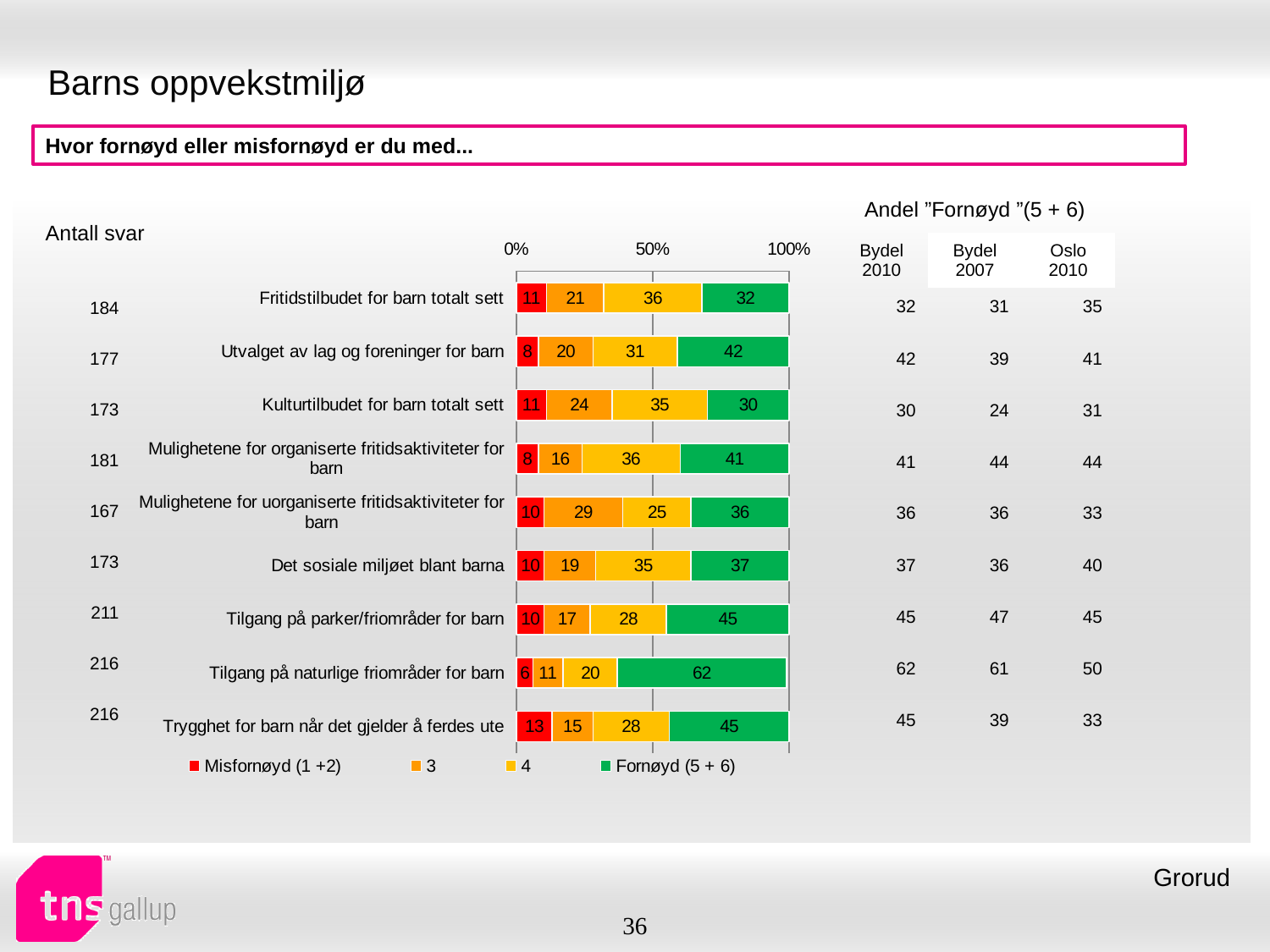
What kind of chart is shown on the slide? bar chart What is the value of series '3' for 'Mulighetene for uorganiserte fritidsaktiviteter for barn'? 29 What is the 'Misfornøyd (1 +2)' value for 'Trygghet for barn når det gjelder å ferdes ute'? 13 Which series is shown in green in the chart? Fornøyd (5 + 6) What is the difference between the 'Fornøyd (5 + 6)' values for 'Utvalget av lag og foreninger for barn' and 'Fritidstilbudet for barn totalt sett'? 10 Which category has the highest 'Fornøyd (5 + 6)' value? Tilgang på naturlige friområder for barn How many series does the chart legend list? 4 What is the 'Fornøyd (5 + 6)' value for 'Tilgang på naturlige friområder for barn'? 62 Which has a larger 'Fornøyd (5 + 6)' value: 'Det sosiale miljøet blant barna' or 'Tilgang på parker/friområder for barn'? Tilgang på parker/friområder for barn Which category has the lowest 'Fornøyd (5 + 6)' value? Kulturtilbudet for barn totalt sett How many categories (rows) does the chart show? 9 What is the total of the stacked bar for 'Kulturtilbudet for barn totalt sett'? 100